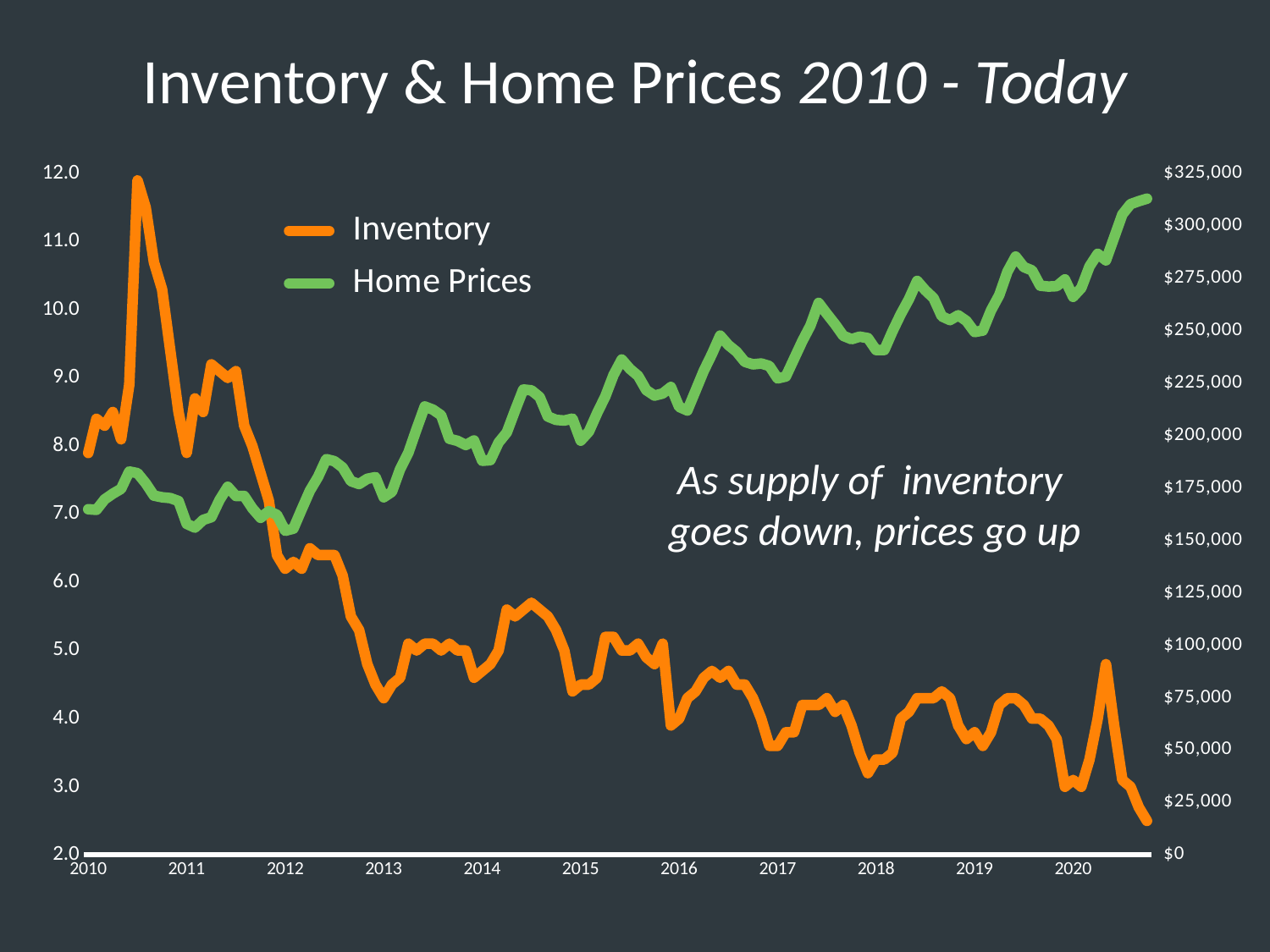
Is the Home Prices value at the start of 2010 greater or less than $200,000? less Is the peak value of Inventory in 2010 greater or less than 11.0? greater Which series is drawn in orange? Inventory What kind of chart is shown on the slide? line chart Is the Home Prices value at the start of 2017 greater or less than $200,000? greater How many series does the legend list? 2 Overall, do Home Prices rise or fall from 2010 to 2020? rise Overall, does Inventory rise or fall from 2010 to 2020? fall What is the title of the chart? Inventory & Home Prices 2010 - Today How many year labels are shown on the x axis? 11